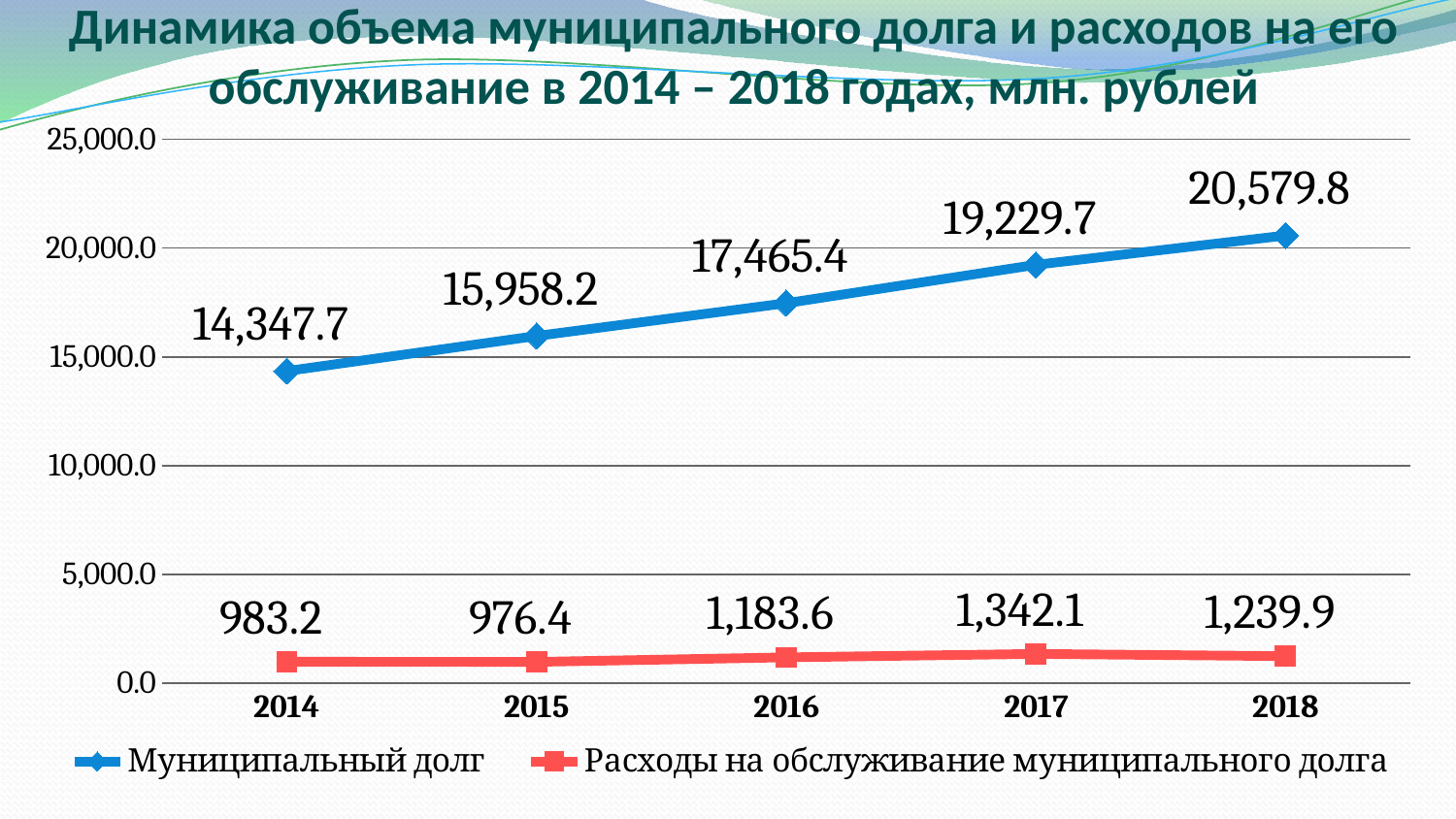
Which is larger: Расходы на обслуживание муниципального долга in 2016 or in 2015? 2016 What is the value of Муниципальный долг in 2018? 20,579.8 How many years are shown on the x axis? 5 How many series does the legend list? 2 What is the value of Расходы на обслуживание муниципального долга in 2017? 1,342.1 Is the value of Муниципальный долг in 2016 greater or less than 15,000.0? greater What is the difference between Расходы на обслуживание муниципального долга in 2017 and in 2018? 102.2 What is the difference between Муниципальный долг in 2018 and in 2014? 6,232.1 What is the value of Муниципальный долг in 2014? 14,347.7 In which year is Муниципальный долг highest? 2018 In which year is Расходы на обслуживание муниципального долга lowest? 2015 What kind of chart is shown on the slide? line chart